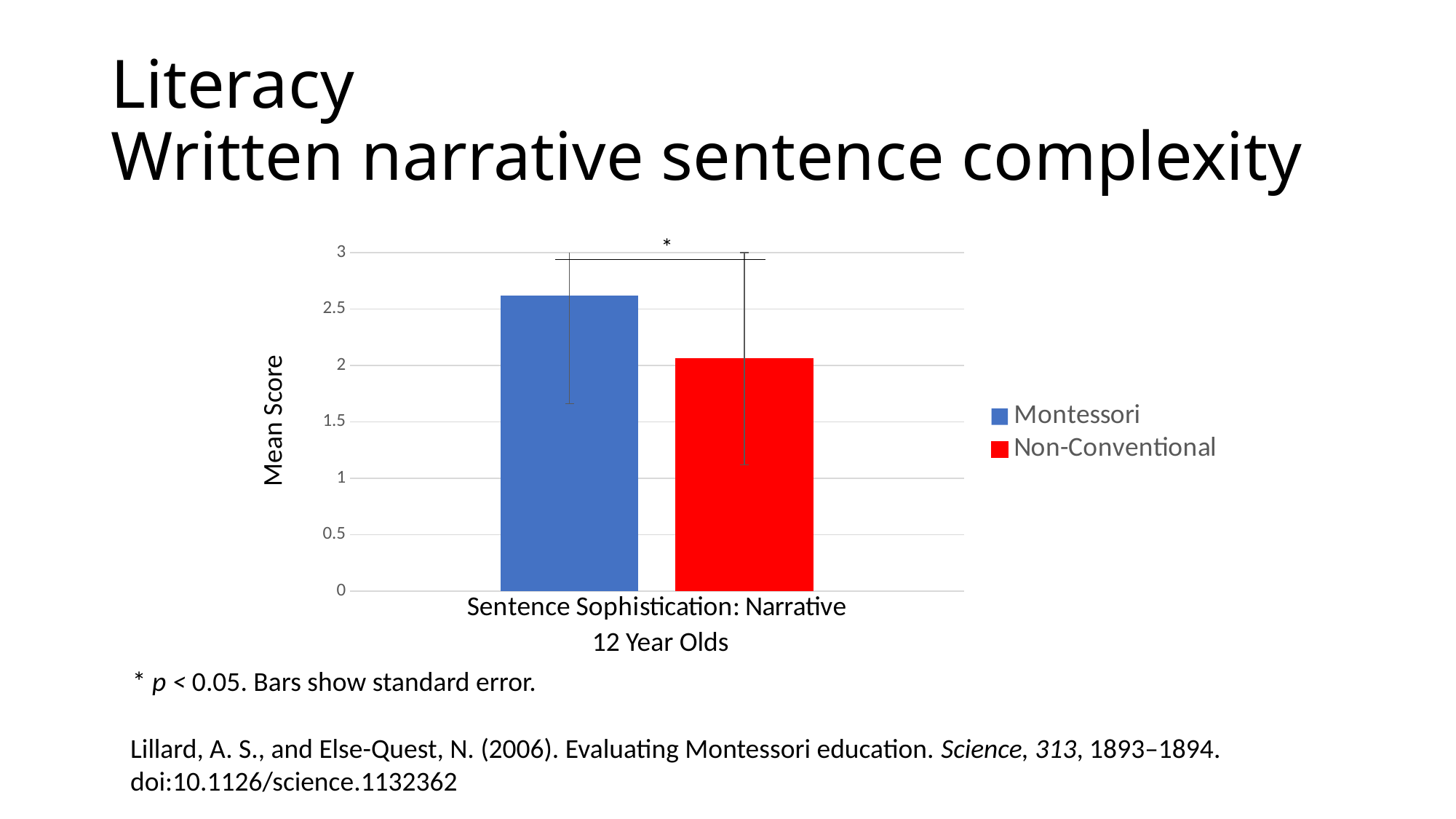
Is the mean score for Montessori greater or less than 2? greater Is the mean score for Montessori larger or smaller than the mean score for Non-Conventional? larger What is the label of the y axis? Mean Score What colour is the bar for Non-Conventional? red How many series does the legend list? 2 Which series has the higher mean score for Sentence Sophistication: Narrative? Montessori Which series has the lower mean score for Sentence Sophistication: Narrative? Non-Conventional Is the mean score for Non-Conventional greater or less than 2.5? less What kind of chart is shown on the slide? bar chart Is the mean score for Non-Conventional greater or less than 1.5? greater How many categories are shown on the x axis? 1